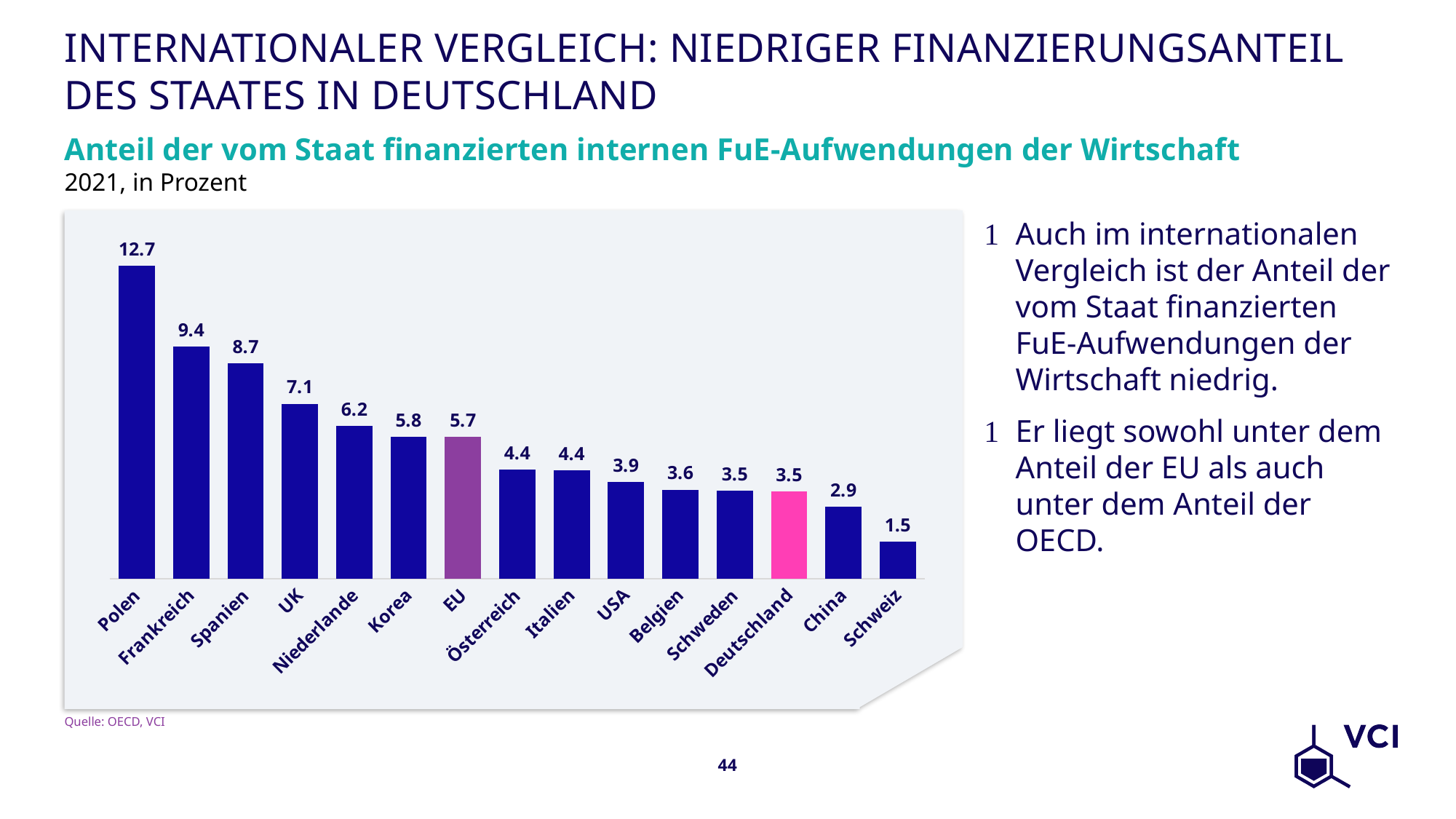
Which country has the lowest value? Schweiz What is the difference between the values for EU and Deutschland? 2.2 Which bar is highlighted in pink? Deutschland Which country has the highest value? Polen How many categories are shown in the chart? 15 Which is larger, the value for UK or the value for Korea? UK What is the value for Polen? 12.7 What is the value for Deutschland? 3.5 Do the values rise or fall from left to right along the x axis? Fall What is the value for EU? 5.7 What is the difference between the values for Frankreich and Spanien? 0.7 What kind of chart is shown on the slide? Bar chart